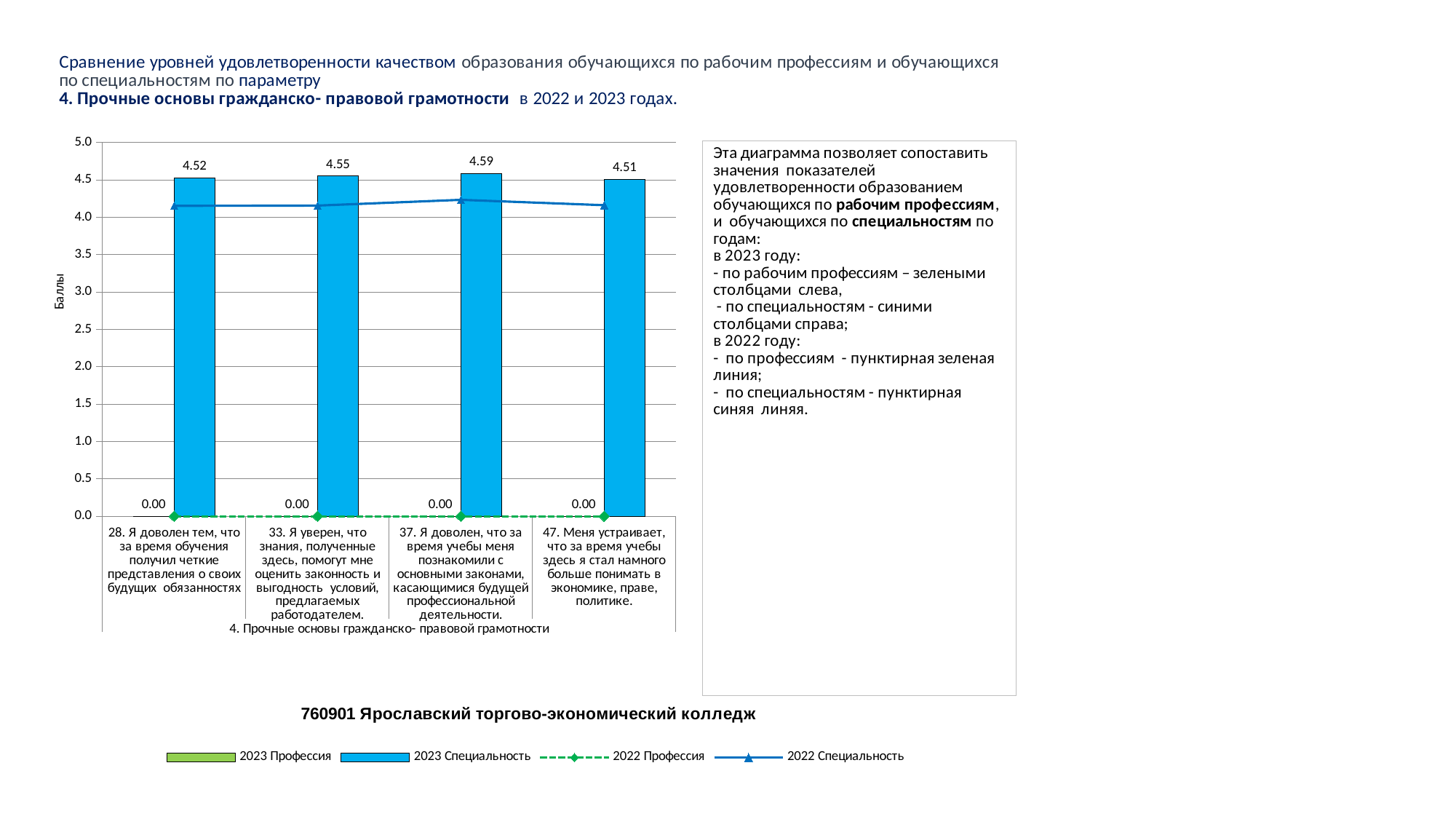
What is the value of the 2023 Специальность bar for item 33 (Я уверен, что знания, полученные здесь, помогут мне оценить законность и выгодность условий, предлагаемых работодателем)? 4.55 Is the 2022 Специальность line value for item 37 greater or less than 4.0? greater What is the value of the 2023 Специальность bar for item 28 (Я доволен тем, что за время обучения получил четкие представления о своих будущих обязанностях)? 4.52 Which item has the lowest 2023 Специальность value? 47. Меня устраивает, что за время учебы здесь я стал намного больше понимать в экономике, праве, политике What is the difference between the 2023 Специальность values for item 37 and item 47? 0.08 What is the value of the 2023 Специальность bar for item 47 (Меня устраивает, что за время учебы здесь я стал намного больше понимать в экономике, праве, политике)? 4.51 How many series does the chart legend list? 4 Which is larger: the 2023 Специальность value for item 33 or for item 28? item 33 How many items (categories) are shown on the x axis of the chart? 4 What is the label of the vertical axis of the chart? Баллы Which item has the highest 2023 Специальность value? 37. Я доволен, что за время учебы меня познакомили с основными законами, касающимися будущей профессиональной деятельности What value is shown for the 2023 Профессия series for item 28? 0.00